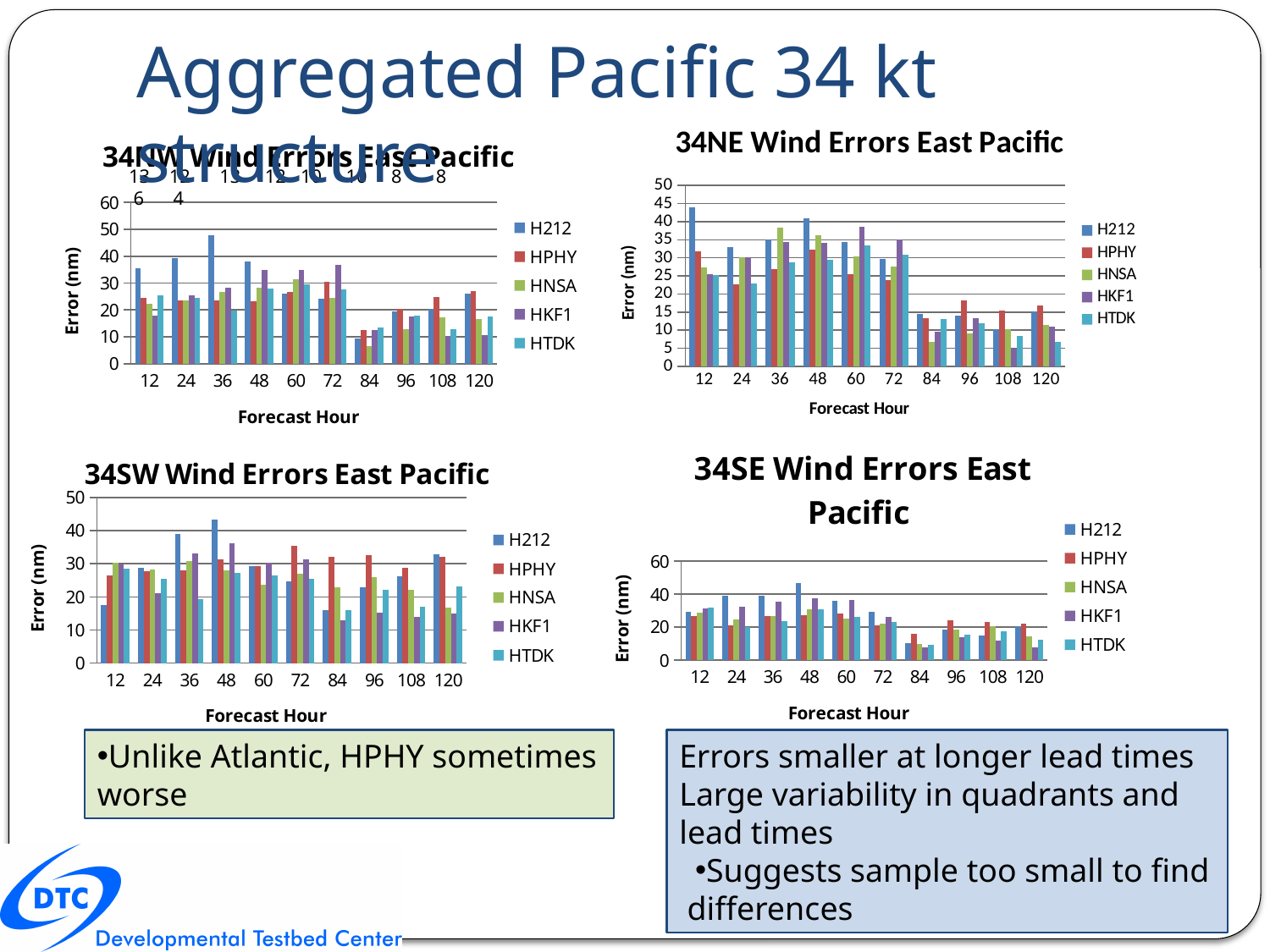
In the 34SE Wind Errors East Pacific chart, is the H212 value at forecast hour 48 greater or less than 40? greater How many forecast hours are shown on the x axis of the 34SE Wind Errors East Pacific chart? 10 How many series does the legend of the 34SW Wind Errors East Pacific chart list? 5 In the 34NE Wind Errors East Pacific chart, is the HKF1 value at forecast hour 108 greater or less than 10? less What kind of chart is the 34NE Wind Errors East Pacific chart? bar chart In the 34NE Wind Errors East Pacific chart, is the H212 value at forecast hour 12 greater or less than 40? greater In the 34NE Wind Errors East Pacific chart, do the H212 values generally rise or fall from forecast hour 12 to 120? fall In the 34SE Wind Errors East Pacific chart, at which forecast hour is the H212 bar highest? 48 In the 34SW Wind Errors East Pacific chart, at forecast hour 36, which is larger: H212 or HNSA? H212 In the 34NE Wind Errors East Pacific chart, at which forecast hour is the H212 bar highest? 12